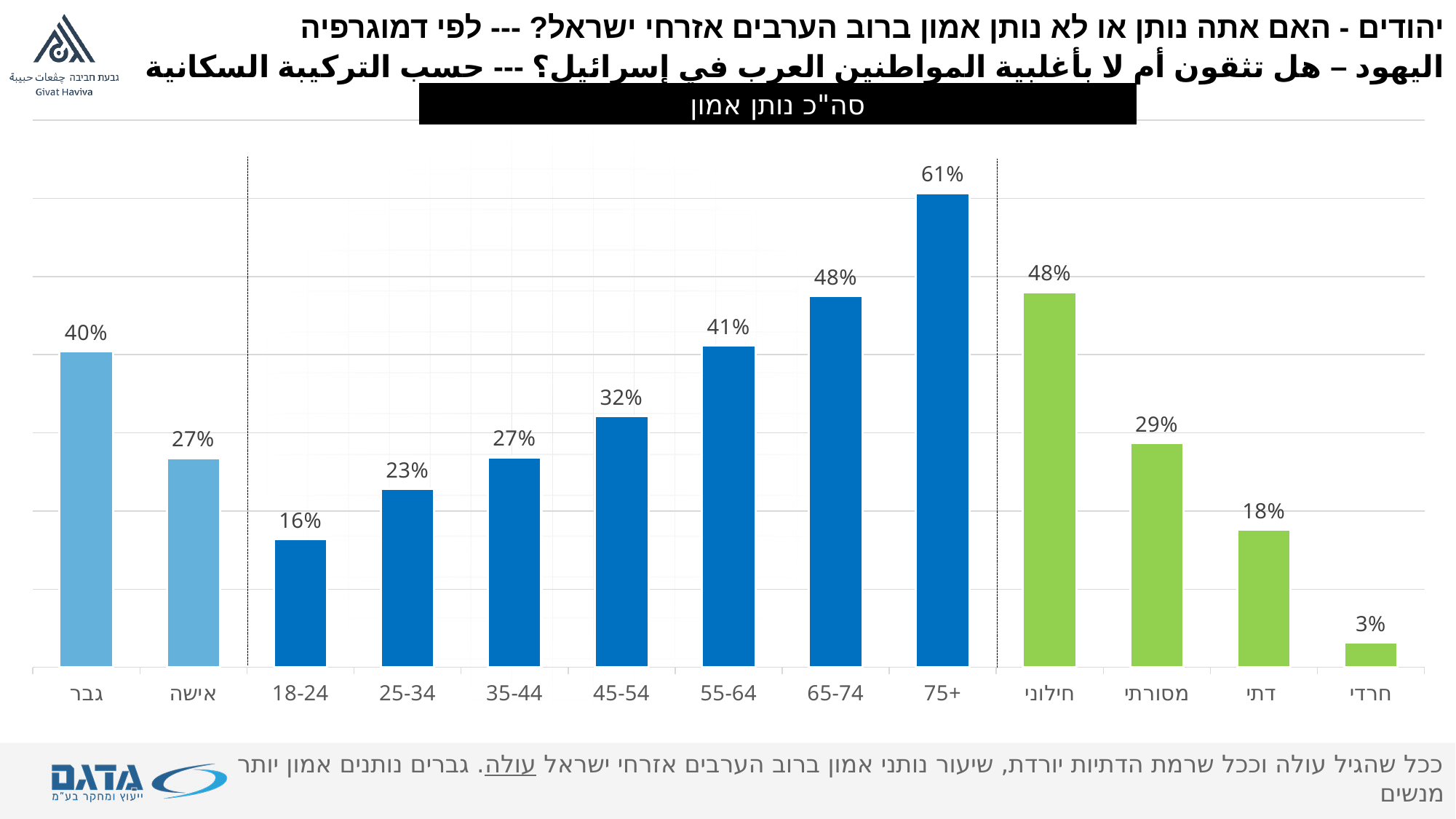
Do the values rise or fall across the age groups from 18-24 to 75+? Rise What is the title shown above the chart? סה"כ נותן אמון What kind of chart is shown on the slide? Bar chart How many categories (bars) are shown in the chart? 13 What is the value for גבר (men)? 40% What is the value for the 45-54 age group? 32% Which is larger, the value for חילוני or the value for מסורתי? חילוני Which category has the lowest value in the chart? חרדי Which category has the highest value in the chart? 75+ What is the value for חרדי? 3% What is the difference between the values for גבר and אישה? 13% What is the value for the 75+ age group? 61%